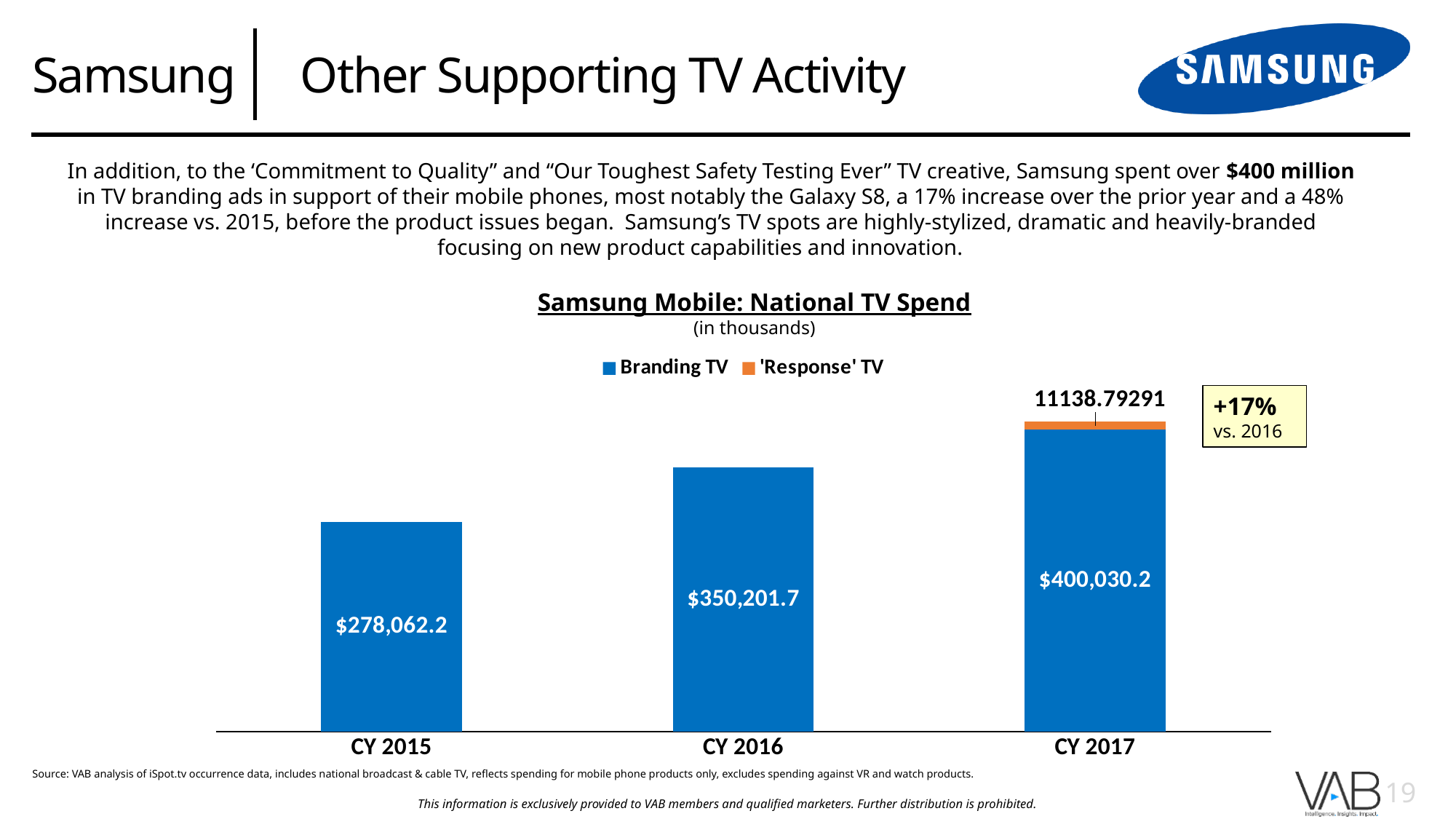
Which year has the highest Branding TV spend? CY 2017 How many years are shown on the x axis of the chart? 3 Which year has the lowest Branding TV spend? CY 2015 What is the Branding TV spend for CY 2017? $400,030.2 What is the Branding TV spend for CY 2016? $350,201.7 How many series does the legend of the Samsung Mobile: National TV Spend chart list? 2 What kind of chart is shown on the slide? bar chart What is the Branding TV spend for CY 2015? $278,062.2 Do the Branding TV values rise or fall from CY 2015 to CY 2017? rise What is the 'Response' TV value labelled for CY 2017? 11138.79291 What is the difference in Branding TV spend between CY 2017 and CY 2016? $49,828.5 What percentage change vs. 2016 is called out next to the CY 2017 bar? +17%